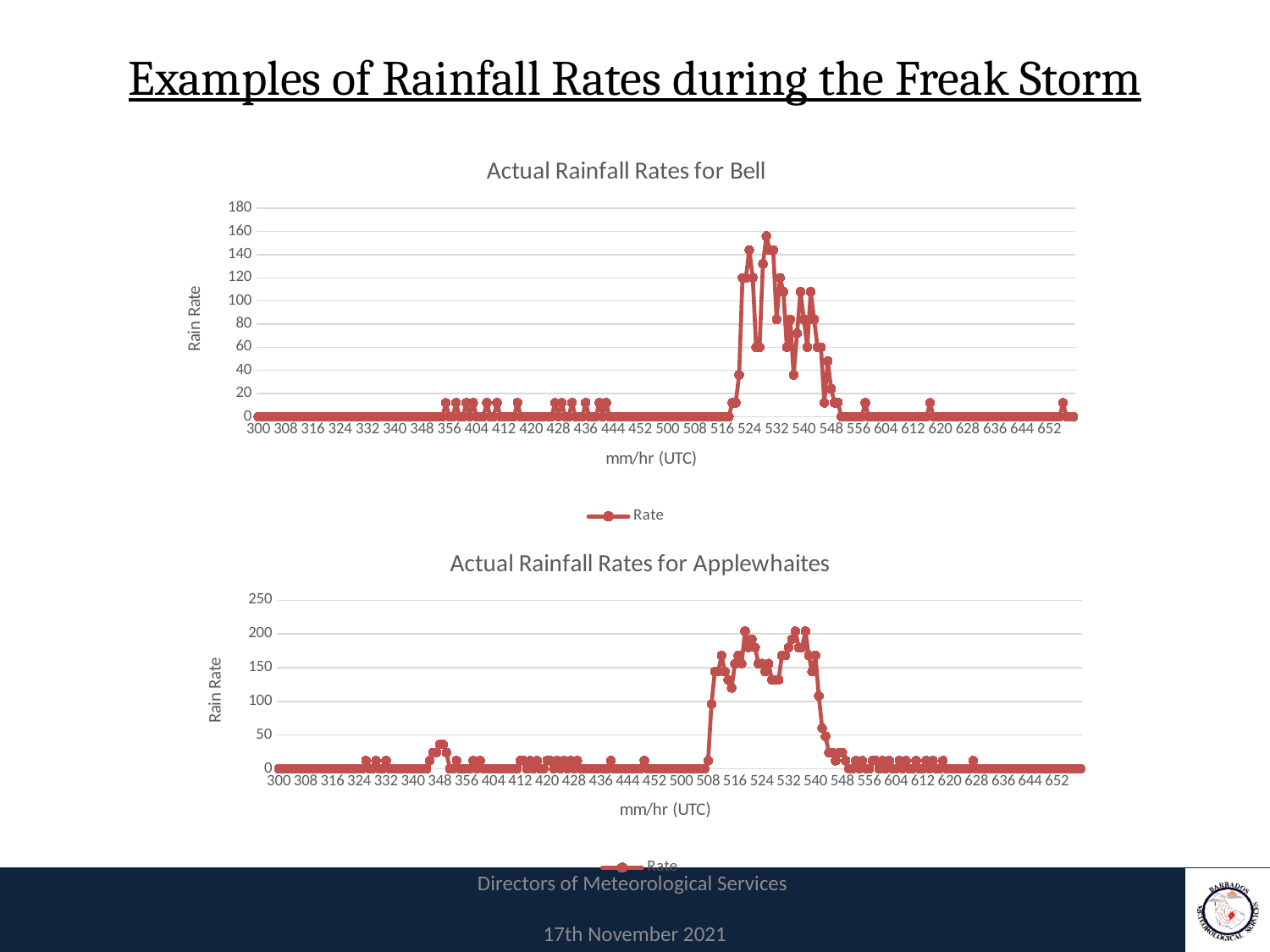
In the 'Actual Rainfall Rates for Bell' chart, do the values rise or fall between 516 and 528 on the x axis? rise In the 'Actual Rainfall Rates for Bell' chart, is the value at 300 greater or less than 20? less In the 'Actual Rainfall Rates for Applewhaites' chart, is the highest plotted rain rate greater or less than 150? greater What is the label of the y axis on the 'Actual Rainfall Rates for Bell' chart? Rain Rate What is the legend entry shown below the 'Actual Rainfall Rates for Bell' chart? Rate In the 'Actual Rainfall Rates for Applewhaites' chart, is the value at 652 greater or less than 50? less What kind of chart is the 'Actual Rainfall Rates for Bell' chart? line chart Which chart reaches a higher peak rain rate, 'Actual Rainfall Rates for Bell' or 'Actual Rainfall Rates for Applewhaites'? Actual Rainfall Rates for Applewhaites In the 'Actual Rainfall Rates for Applewhaites' chart, do the values rise or fall between 540 and 548 on the x axis? fall How many series does the legend of the 'Actual Rainfall Rates for Bell' chart list? 1 What kind of chart is the 'Actual Rainfall Rates for Applewhaites' chart? line chart